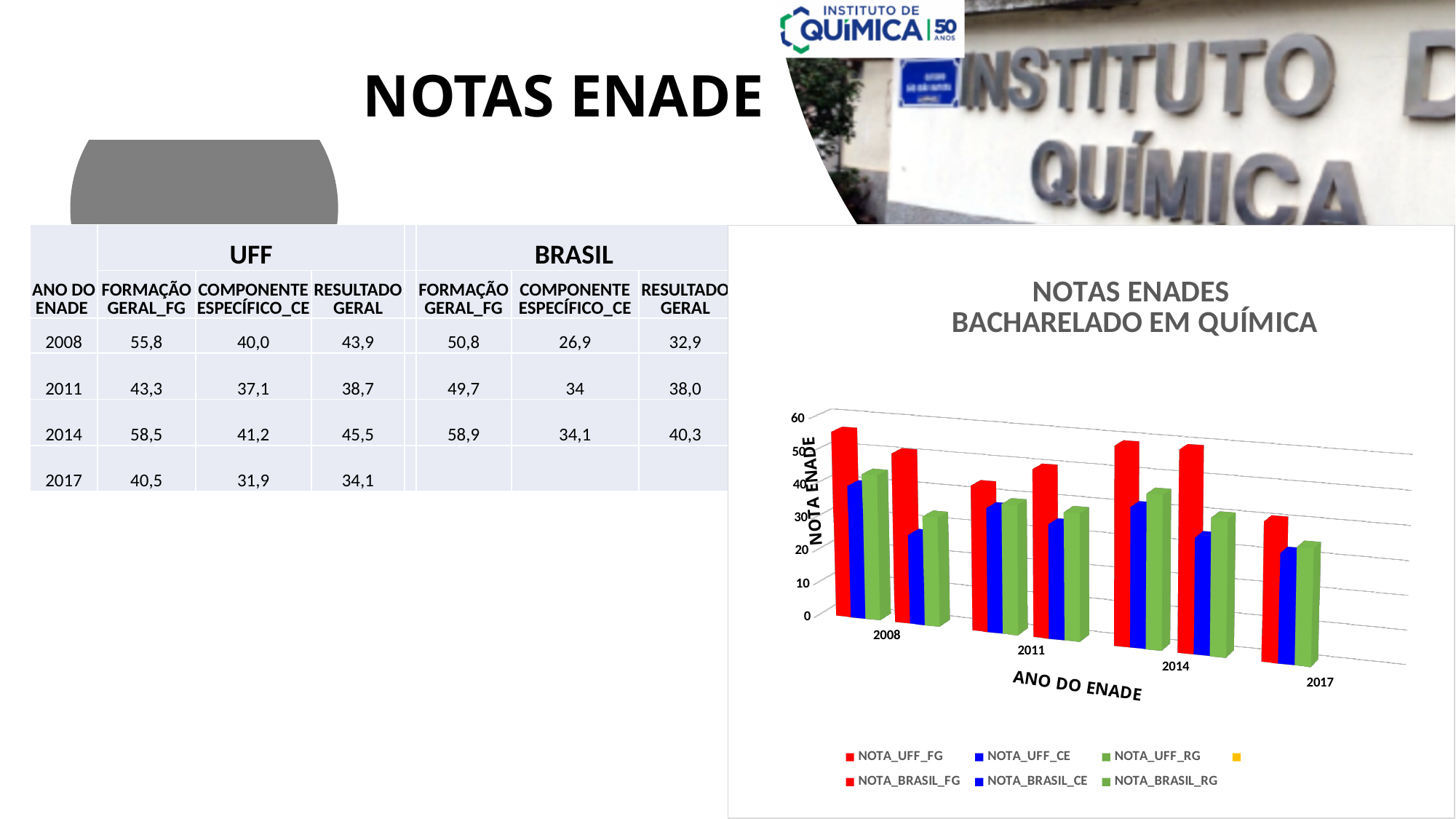
How many years are shown on the x axis of the chart? 4 What is the title of the chart? NOTAS ENADES BACHARELADO EM QUÍMICA In which year is NOTA_UFF_FG lowest? 2017 In 2008, which is larger, NOTA_UFF_FG or NOTA_UFF_CE? NOTA_UFF_FG What is the label of the vertical axis of the chart? NOTA ENADE Is the value for NOTA_UFF_CE in 2008 greater or less than 30? greater Is the value for NOTA_BRASIL_FG in 2008 greater or less than 40? greater What kind of chart is shown on the slide? bar chart Is the value for NOTA_UFF_FG in 2008 greater or less than 50? greater Does NOTA_UFF_CE rise or fall from 2014 to 2017? fall